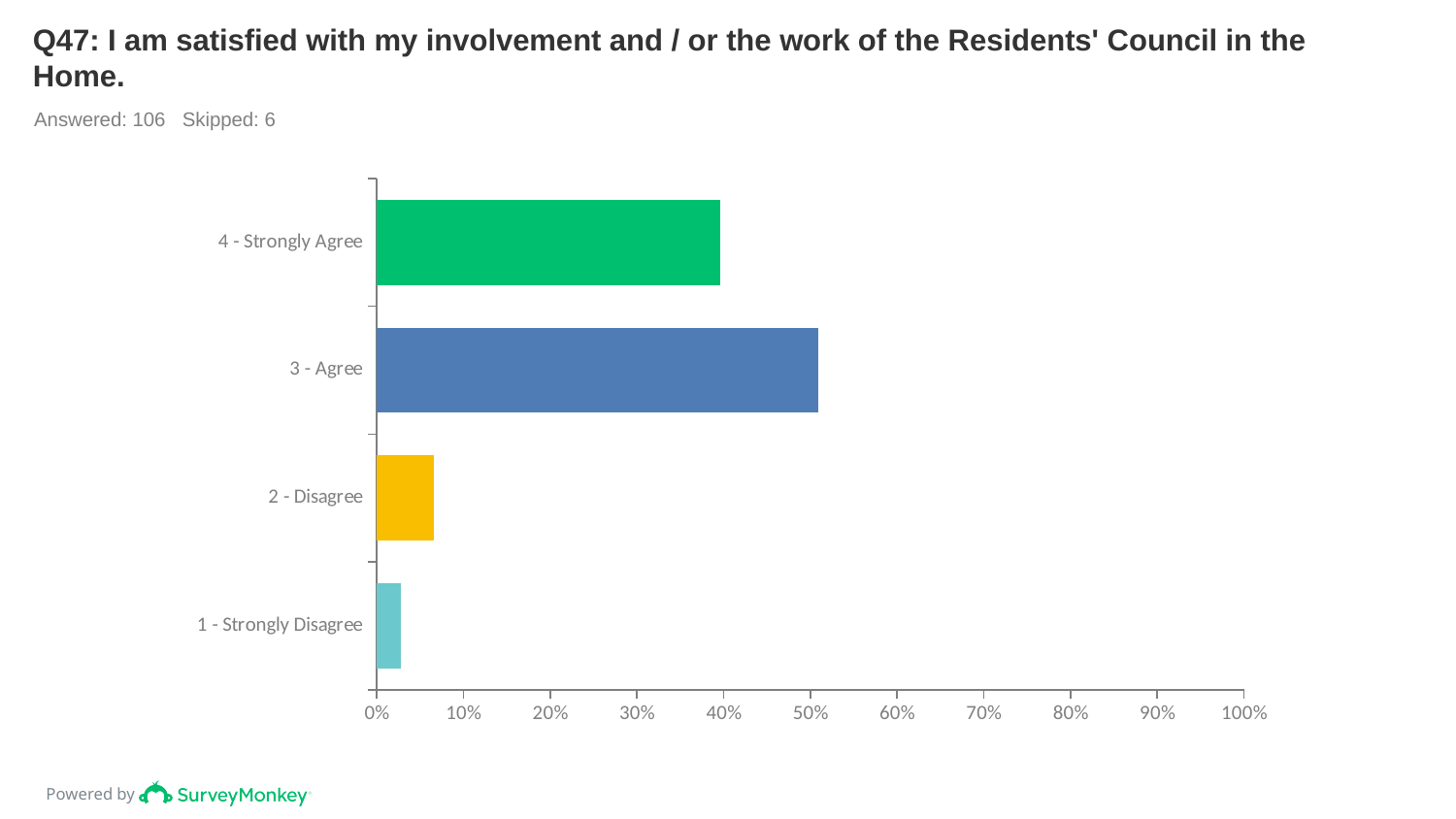
Is the value for 2 - Disagree greater or less than 10%? less How many response categories are shown in the chart? 4 What is the question number shown in the chart title? Q47 Which is larger, the value for 2 - Disagree or the value for 1 - Strongly Disagree? 2 - Disagree How many respondents answered this question according to the slide? 106 Which is larger, the value for 3 - Agree or the value for 4 - Strongly Agree? 3 - Agree Is the value for 1 - Strongly Disagree greater or less than 10%? less Is the value for 3 - Agree greater or less than 40%? greater What kind of chart is shown on the slide? bar chart Which response category has the highest value? 3 - Agree Which response category has the lowest value? 1 - Strongly Disagree